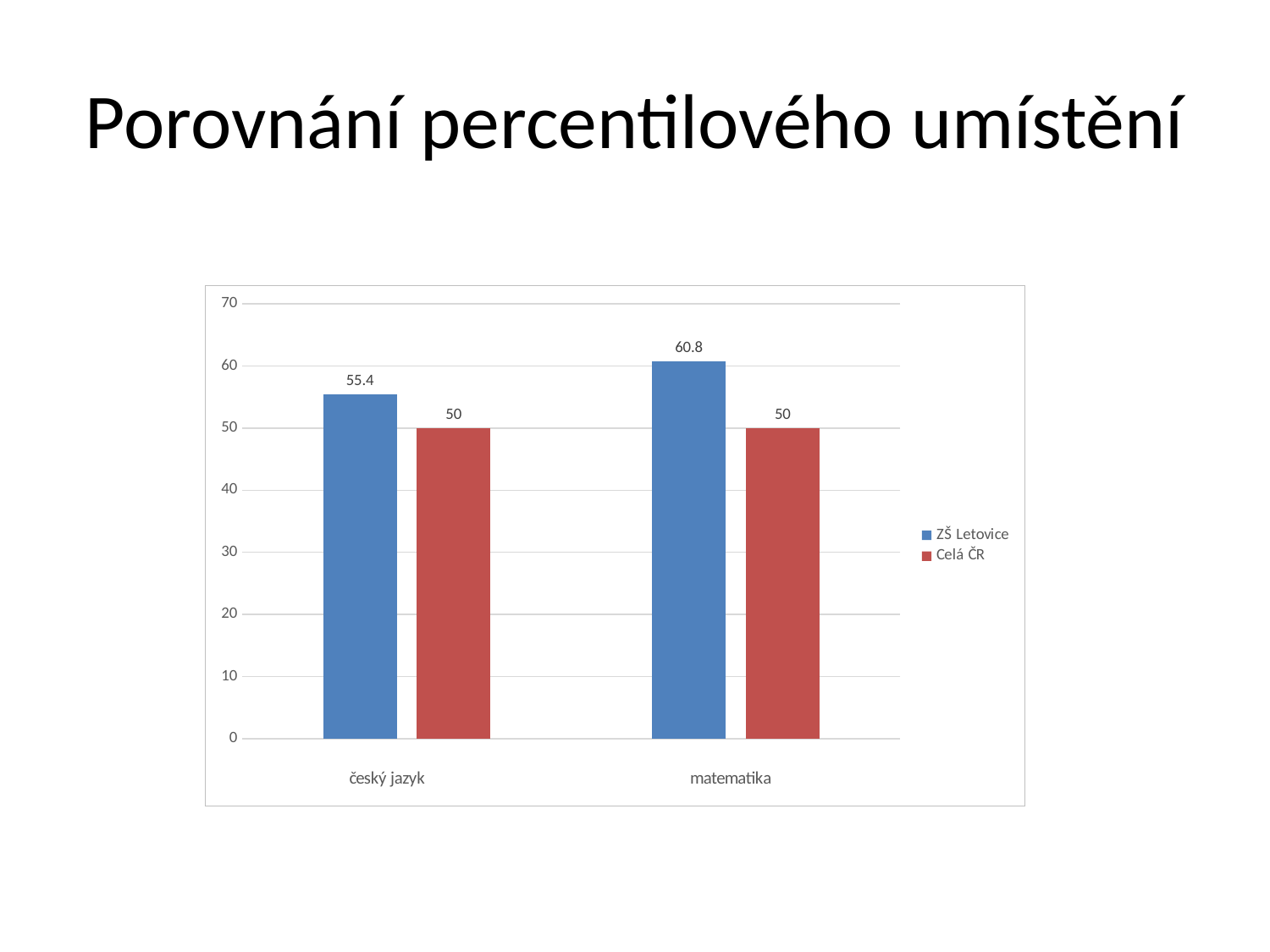
Which is larger in český jazyk: ZŠ Letovice or Celá ČR? ZŠ Letovice What is the value for ZŠ Letovice in český jazyk? 55.4 How many categories are shown on the x axis? 2 How many series does the legend list? 2 Which category has the highest value for ZŠ Letovice? matematika What is the value for ZŠ Letovice in matematika? 60.8 What is the difference between ZŠ Letovice and Celá ČR in matematika? 10.8 Which category has the lowest value for ZŠ Letovice? český jazyk What is the value for Celá ČR in matematika? 50 What kind of chart is shown on the slide? bar chart What is the difference between ZŠ Letovice and Celá ČR in český jazyk? 5.4 Is the value for ZŠ Letovice in matematika greater or less than 60? greater